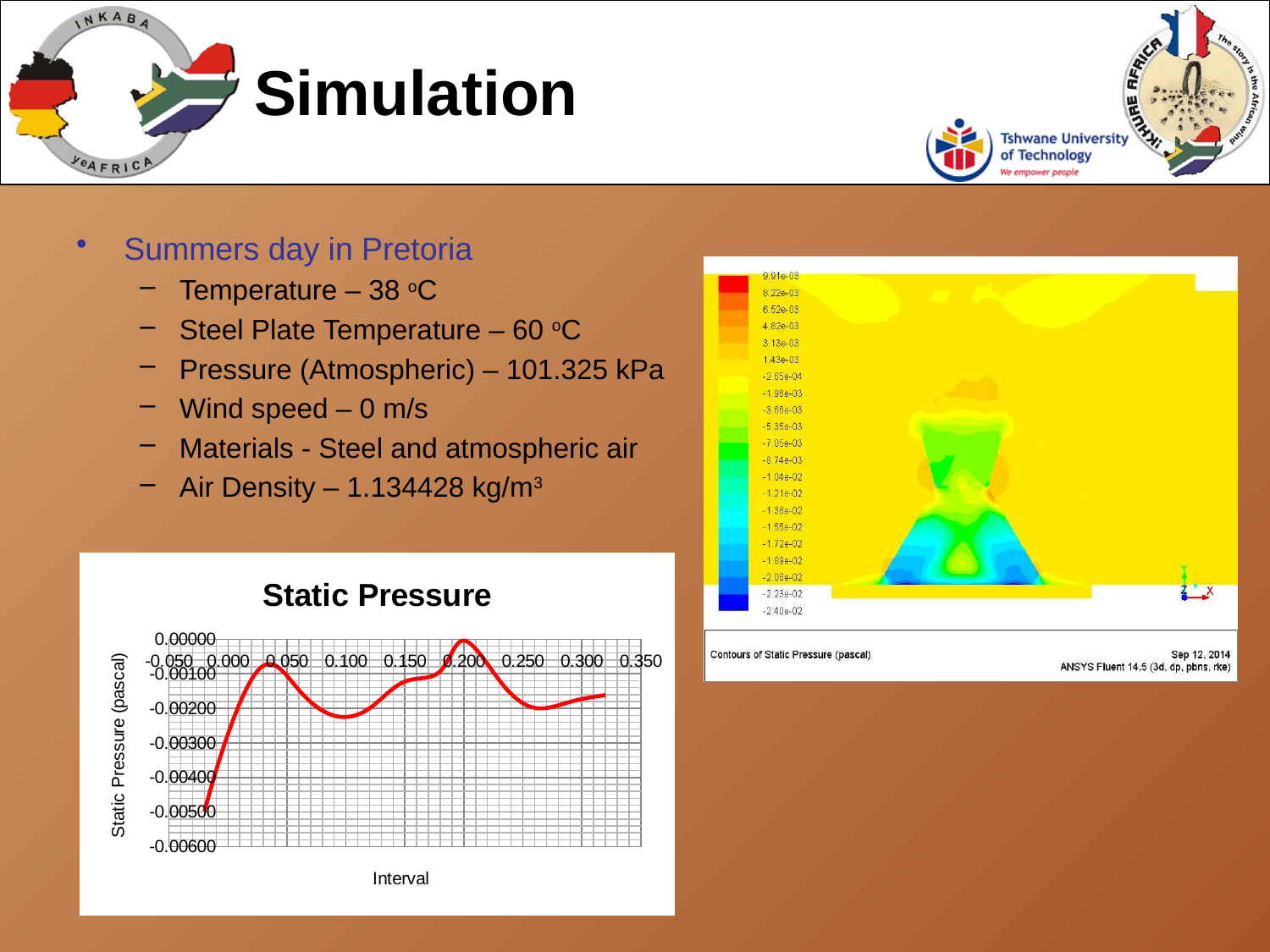
On the "Static Pressure" chart, is the value at interval 0.200 greater or less than -0.00100? greater On the "Static Pressure" chart, is the value at interval 0.050 greater or less than -0.00200? greater How many tick labels are shown on the y axis of the "Static Pressure" chart? 7 On the "Static Pressure" chart, is the value at interval 0.100 greater or less than -0.00300? greater What kind of chart is the "Static Pressure" chart on the slide? line chart On the "Static Pressure" chart, which is larger: the value at interval 0.200 or the value at interval 0.100? the value at interval 0.200 On the "Static Pressure" chart, does the line rise or fall between interval 0.000 and interval 0.050? rise What is the title of the chart at the bottom left of the slide? Static Pressure What is the label of the x axis on the "Static Pressure" chart? Interval On the "Static Pressure" chart, does the line rise or fall between interval 0.200 and interval 0.250? fall